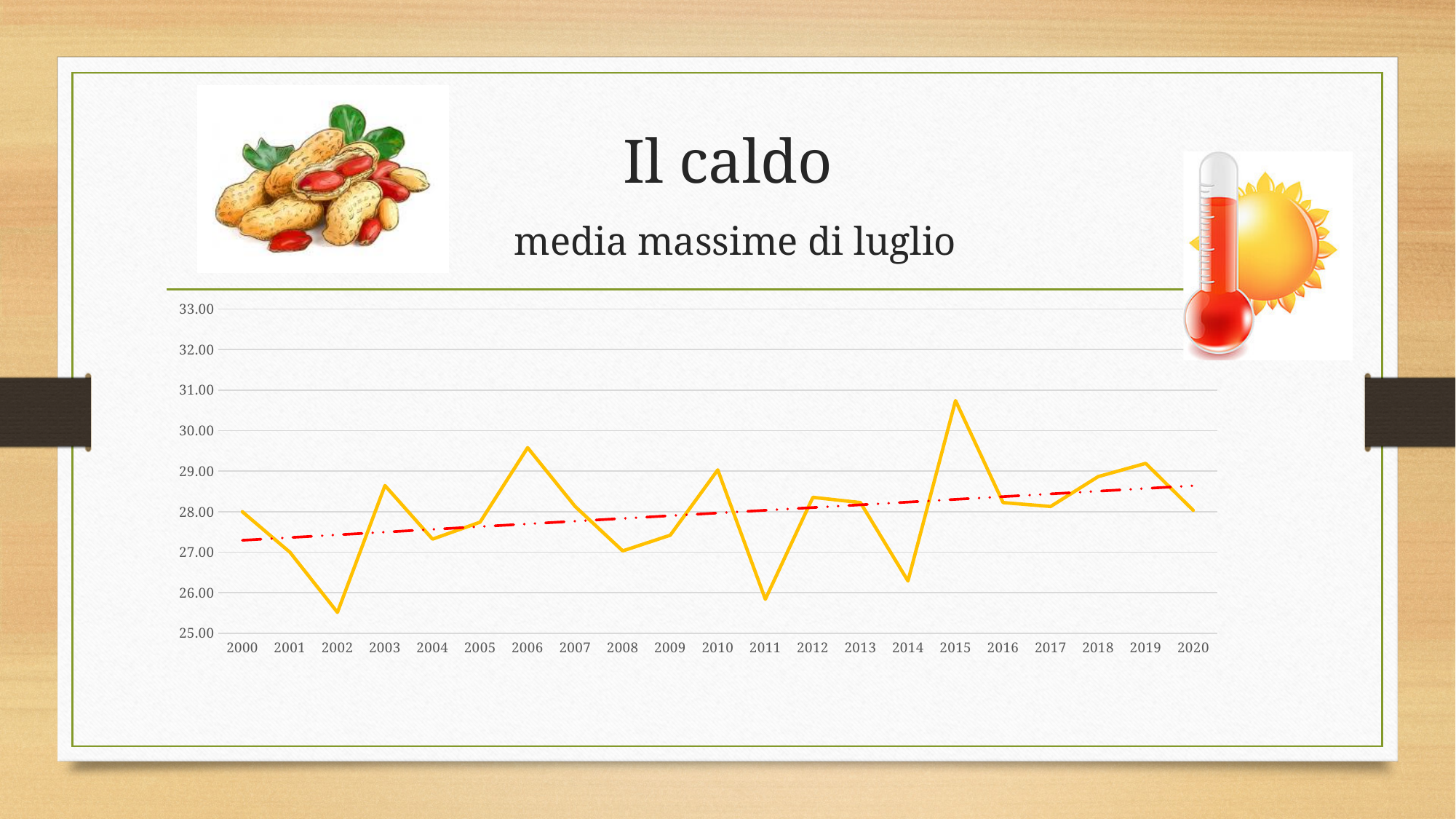
Is the value for 2002 greater or less than 26.00? less Is the value for 2011 greater or less than 27.00? less Is the value for 2015 greater or less than 30.00? greater Which year has the highest value in the chart? 2015 Which year has the lowest value in the chart? 2002 How many years are plotted along the x axis of the chart? 21 What colour is the dashed trend line in the chart? red What kind of chart is shown on the slide? line chart Does the dashed trend line in the chart rise or fall from 2000 to 2020? rise Which year has the larger value, 2006 or 2010? 2006